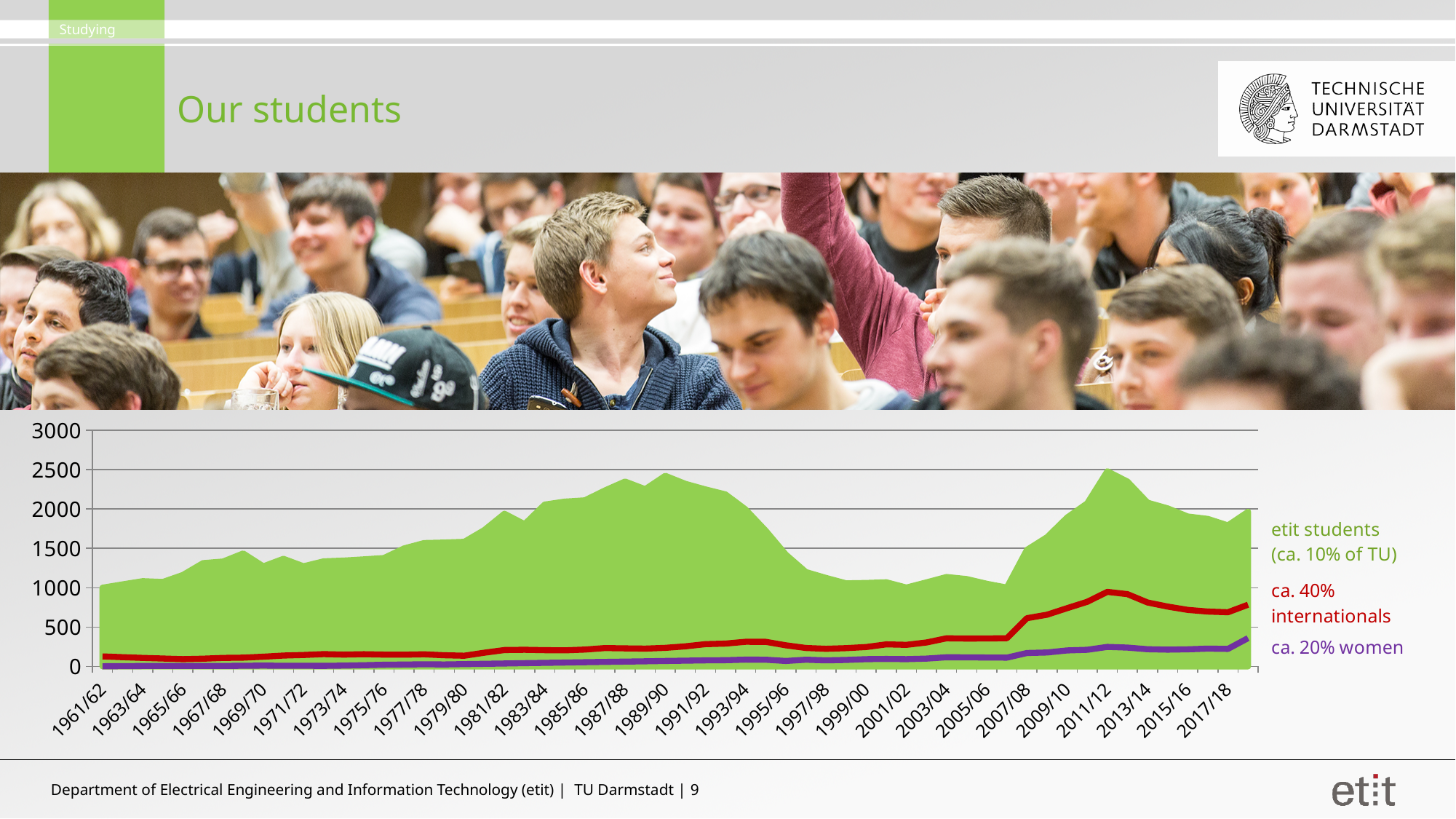
Is the value for women in 2017/18 greater or less than 500? less What colour is the area representing etit students? green What kind of chart is shown on the slide? combination area and line chart Is the value for etit students in 1961/62 greater or less than 500? greater Is the value for internationals in 2011/12 greater or less than 500? greater Do the etit student numbers rise or fall between 1989/90 and 1997/98? fall In 2011/12, which series has the larger value, internationals or women? internationals Which is larger, the number of etit students in 1989/90 or in 2001/02? 1989/90 How many series are labelled on the chart? 3